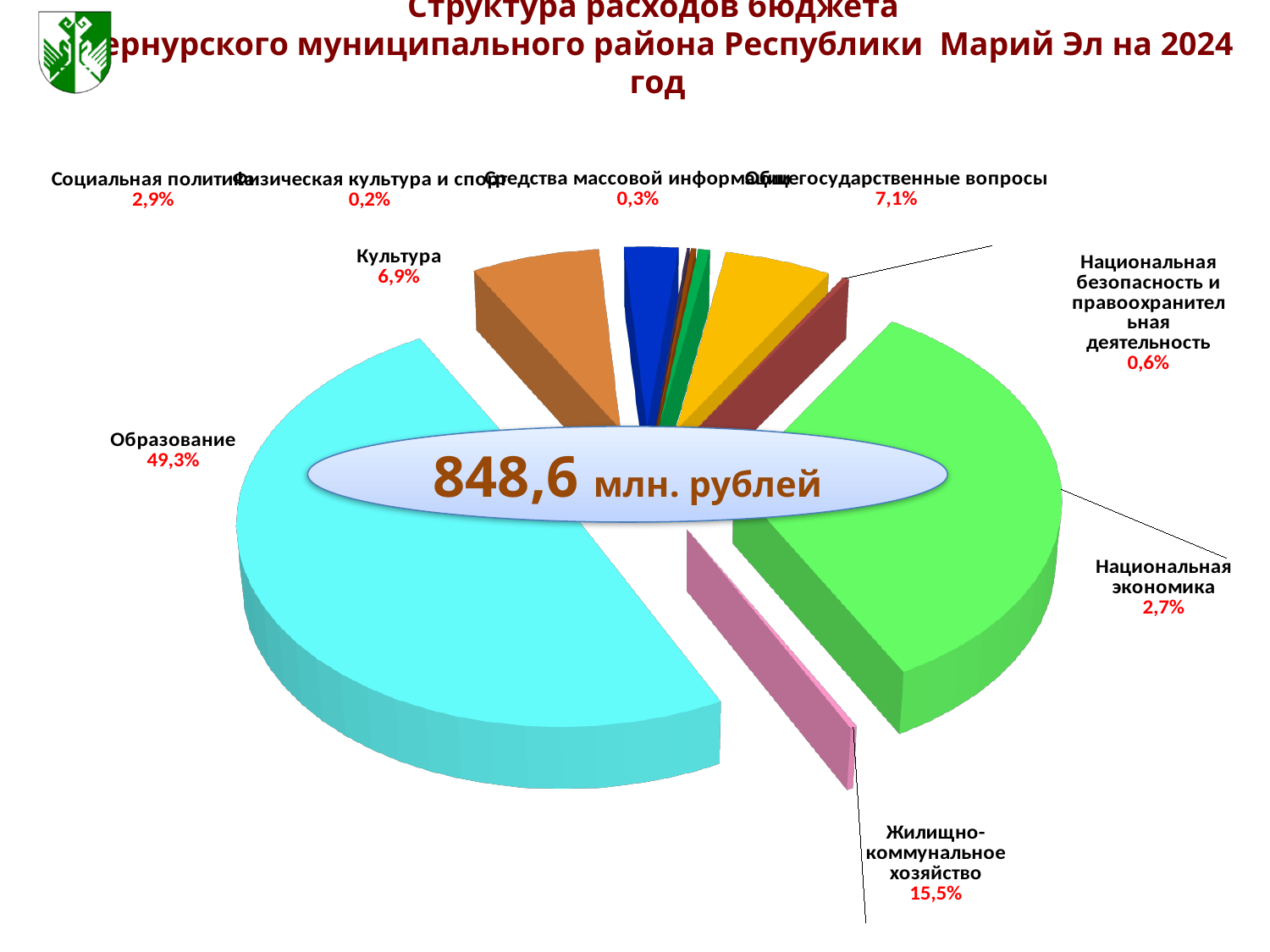
What share is shown for Жилищно-коммунальное хозяйство? 15,5% What kind of chart is shown on the slide? pie chart What share is shown for Национальная экономика? 2,7% By how many percentage points does the share of Образование exceed that of Жилищно-коммунальное хозяйство? 33,8% What total amount is shown in the centre of the pie chart? 848,6 млн. рублей What share of the budget expenditure goes to Образование? 49,3% Which category has the smallest share of the pie? Физическая культура и спорт By how many percentage points does the share of Культура exceed that of Социальная политика? 4,0% Which has the larger share: Культура or Общегосударственные вопросы? Общегосударственные вопросы Which category has the largest share of the pie? Образование What share is shown for Национальная безопасность и правоохранительная деятельность? 0,6%